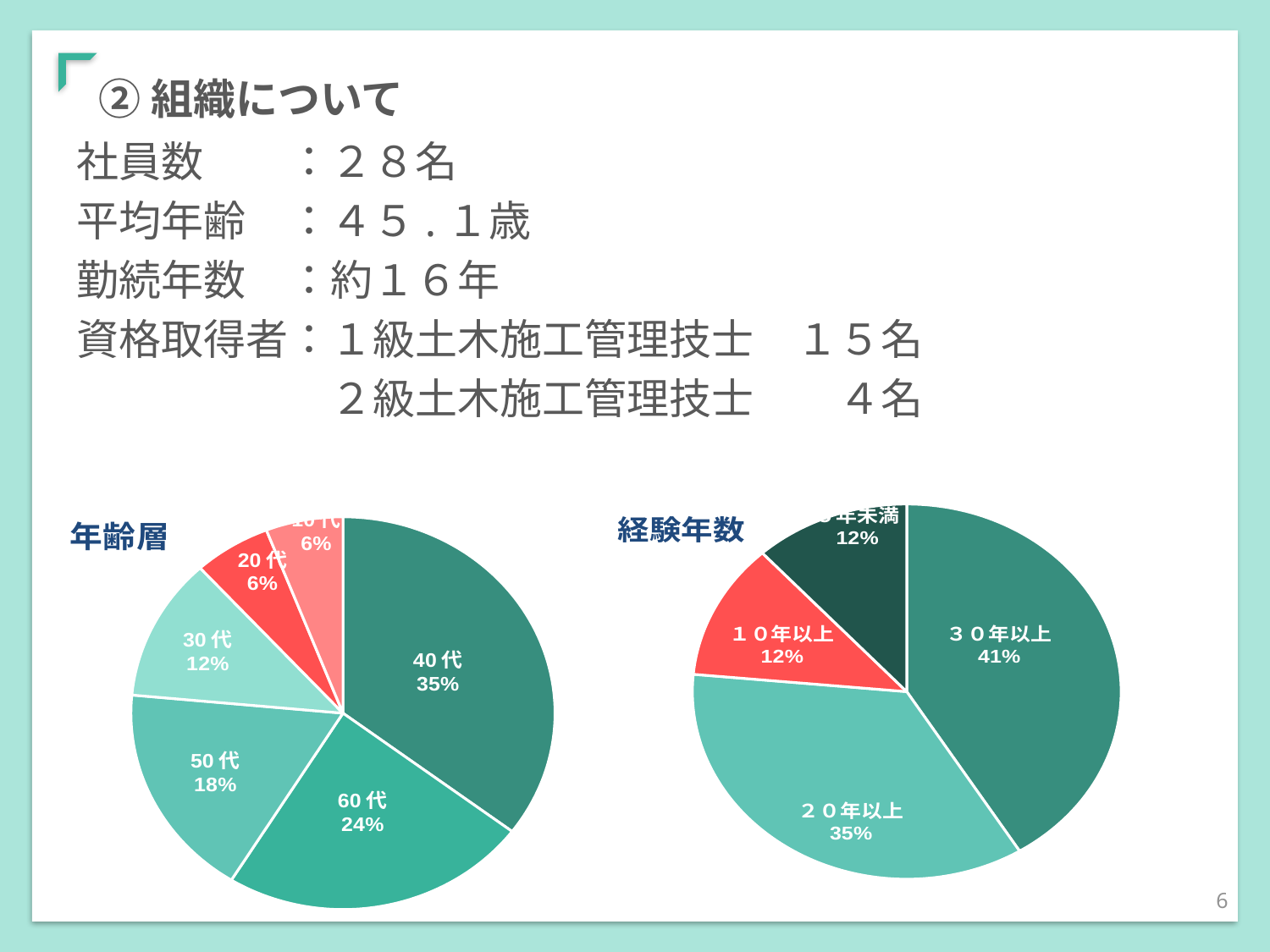
What type of chart is the 年齢層 chart? Pie chart How many slices does the 年齢層 pie chart have? 6 In the 年齢層 chart, which age group has the largest share? 40代 In the 年齢層 chart, what percentage is shown for 50代? 18% In the 年齢層 chart, which is larger, the share for 50代 or the share for 30代? 50代 In the 年齢層 chart, what percentage is shown for 40代? 35% In the 経験年数 chart, which category has the largest share? 30年以上 In the 年齢層 chart, what is the difference in percentage points between 60代 and 30代? 12 In the 経験年数 chart, what percentage is shown for 20年以上? 35% In the 経験年数 chart, what is the difference in percentage points between 30年以上 and 10年以上? 29 How many slices does the 経験年数 pie chart have? 4 In the 経験年数 chart, what percentage is shown for 30年以上? 41%